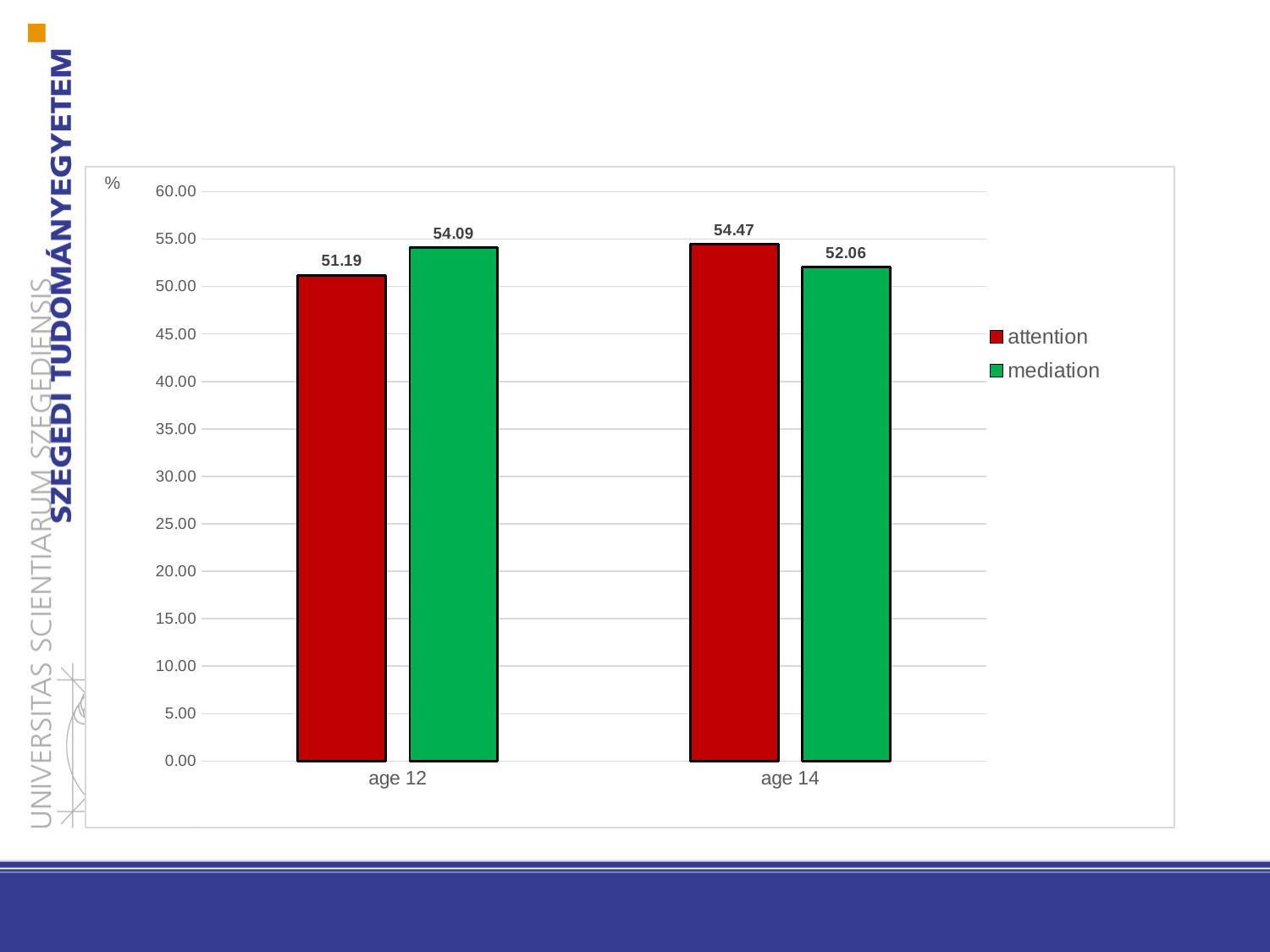
Which series has the higher value at age 14? attention What is the value for attention at age 14? 54.47 What kind of chart is shown on the slide? bar chart Which series has the higher value at age 12? mediation How many series does the legend list? 2 What is the difference between the mediation and attention values at age 12? 2.90 What colour are the attention bars? red What is the value for attention at age 12? 51.19 What is the value for mediation at age 14? 52.06 Which bar has the lowest value in the chart? attention at age 12 What is the difference between the attention and mediation values at age 14? 2.41 What is the value for mediation at age 12? 54.09